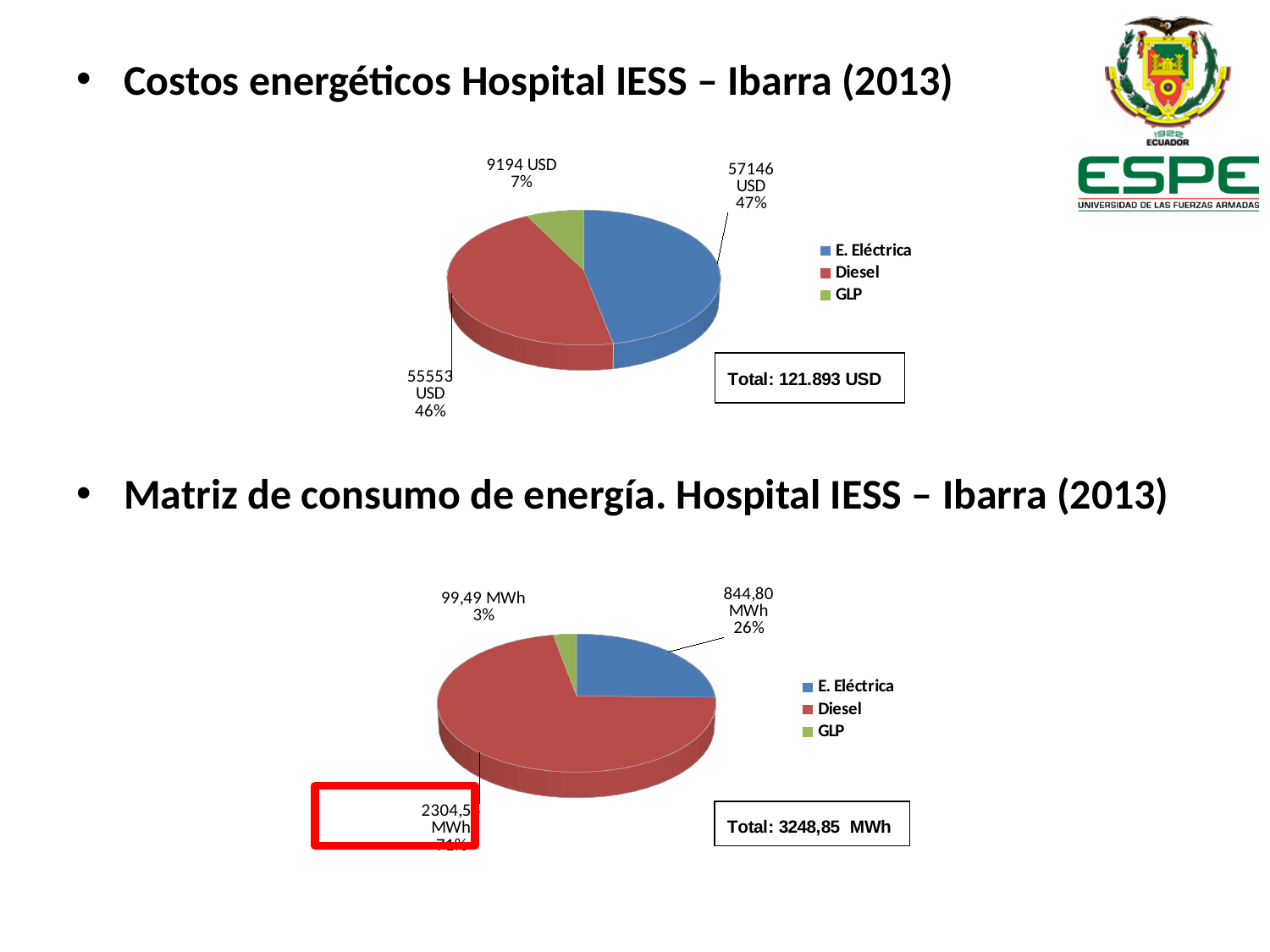
In the bottom chart (Matriz de consumo de energía), what total is shown in the box? 3248,85 MWh What kind of chart is used for the Matriz de consumo de energía? Pie chart In the top chart (Costos energéticos), which category has the smallest cost? GLP In the bottom chart (Matriz de consumo de energía), what percentage share does GLP have? 3% In the top chart (Costos energéticos), what total is shown in the box? 121.893 USD In the top chart (Costos energéticos), what is the cost for E. Eléctrica? 57146 USD In the bottom chart (Matriz de consumo de energía), which category has the largest consumption? Diesel In the top chart (Costos energéticos), what is the cost for Diesel? 55553 USD In the top chart (Costos energéticos), what is the difference in USD between E. Eléctrica and Diesel? 1593 USD In the top chart (Costos energéticos), what percentage share does GLP have? 7% How many entries does the legend of the bottom chart list? 3 In the bottom chart (Matriz de consumo de energía), what is the consumption for E. Eléctrica? 844,80 MWh